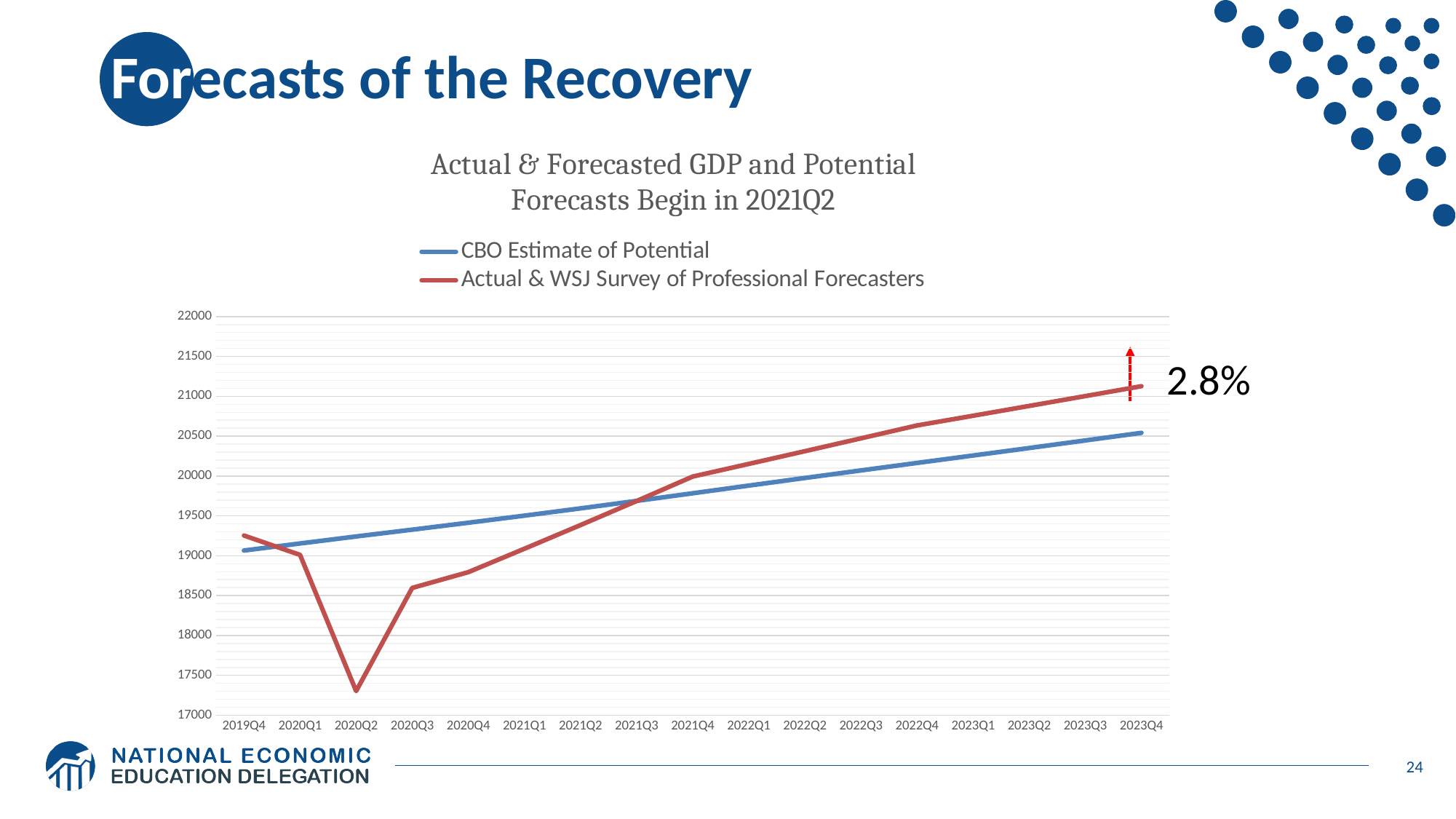
Does the CBO Estimate of Potential line rise or fall from 2019Q4 to 2023Q4? Rise In which quarter does the Actual & WSJ Survey of Professional Forecasters line reach its lowest value? 2020Q2 What kind of chart is shown on the slide? Line chart Is the value of the CBO Estimate of Potential line at 2021Q4 greater or less than 20000? less In which quarter does the Actual & WSJ Survey of Professional Forecasters line reach its highest value? 2023Q4 At 2020Q2, which line is higher: CBO Estimate of Potential or Actual & WSJ Survey of Professional Forecasters? CBO Estimate of Potential Is the value of the Actual & WSJ Survey of Professional Forecasters line at 2023Q4 greater or less than 21000? greater What percentage is annotated next to the end of the red line at 2023Q4? 2.8% At 2023Q4, which line is higher: CBO Estimate of Potential or Actual & WSJ Survey of Professional Forecasters? Actual & WSJ Survey of Professional Forecasters Is the value of the Actual & WSJ Survey of Professional Forecasters line at 2020Q2 greater or less than 17500? less How many quarters are shown along the x axis of the chart? 17 How many series does the chart legend list? 2